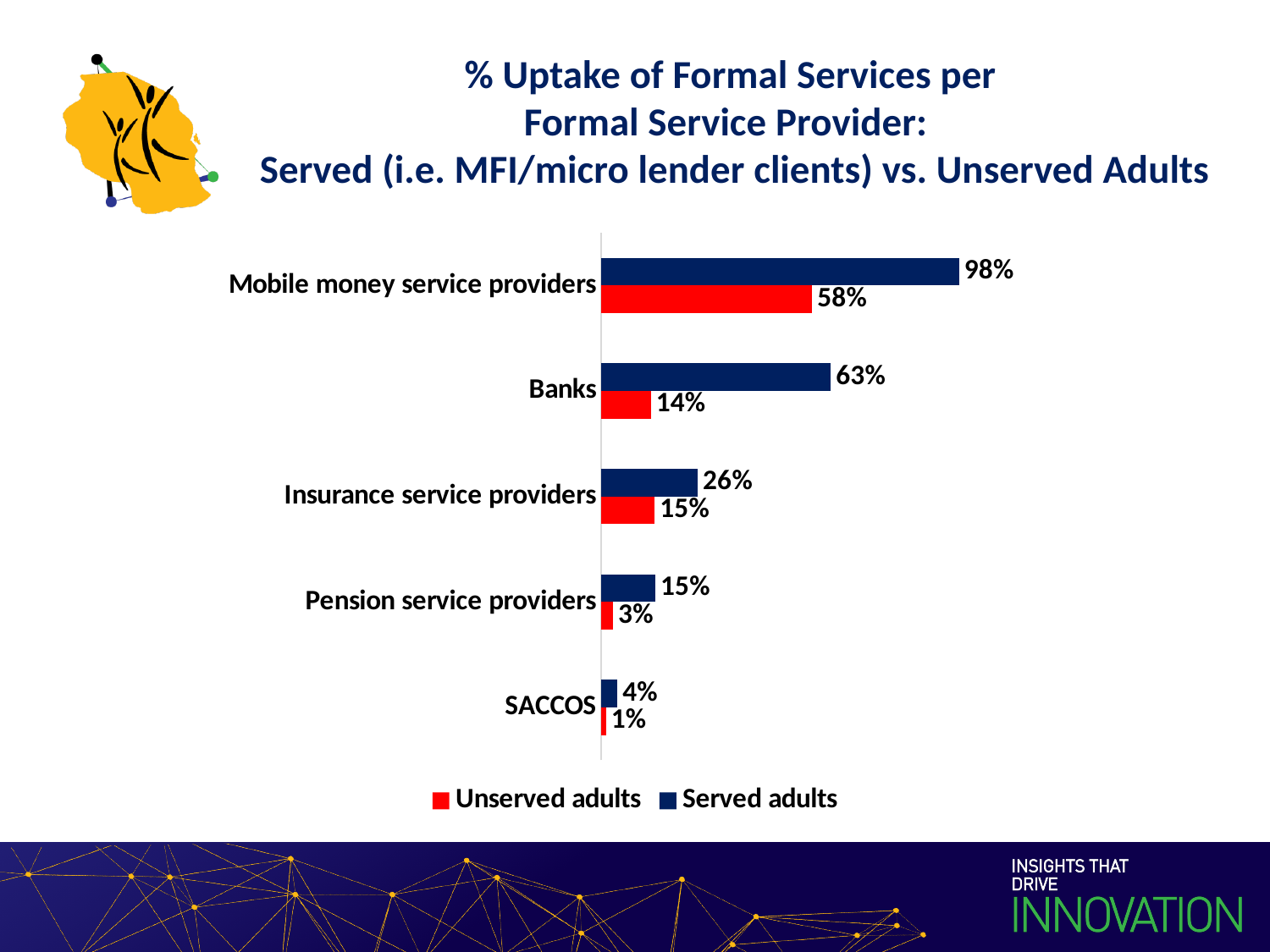
Which category has the highest value for Served adults? Mobile money service providers What is the difference between Served adults and Unserved adults for Mobile money service providers? 40% What is the difference between Served adults and Unserved adults for Banks? 49% How many series does the legend list? 2 What is the value for Unserved adults for Pension service providers? 3% Which colour represents Unserved adults in the chart? Red How many categories are shown on the chart? 5 What is the value for Served adults for Mobile money service providers? 98% What is the value for Unserved adults for Banks? 14% Which is larger for Insurance service providers: Served adults or Unserved adults? Served adults What kind of chart is shown on the slide? Bar chart Which category has the lowest value for Unserved adults? SACCOS